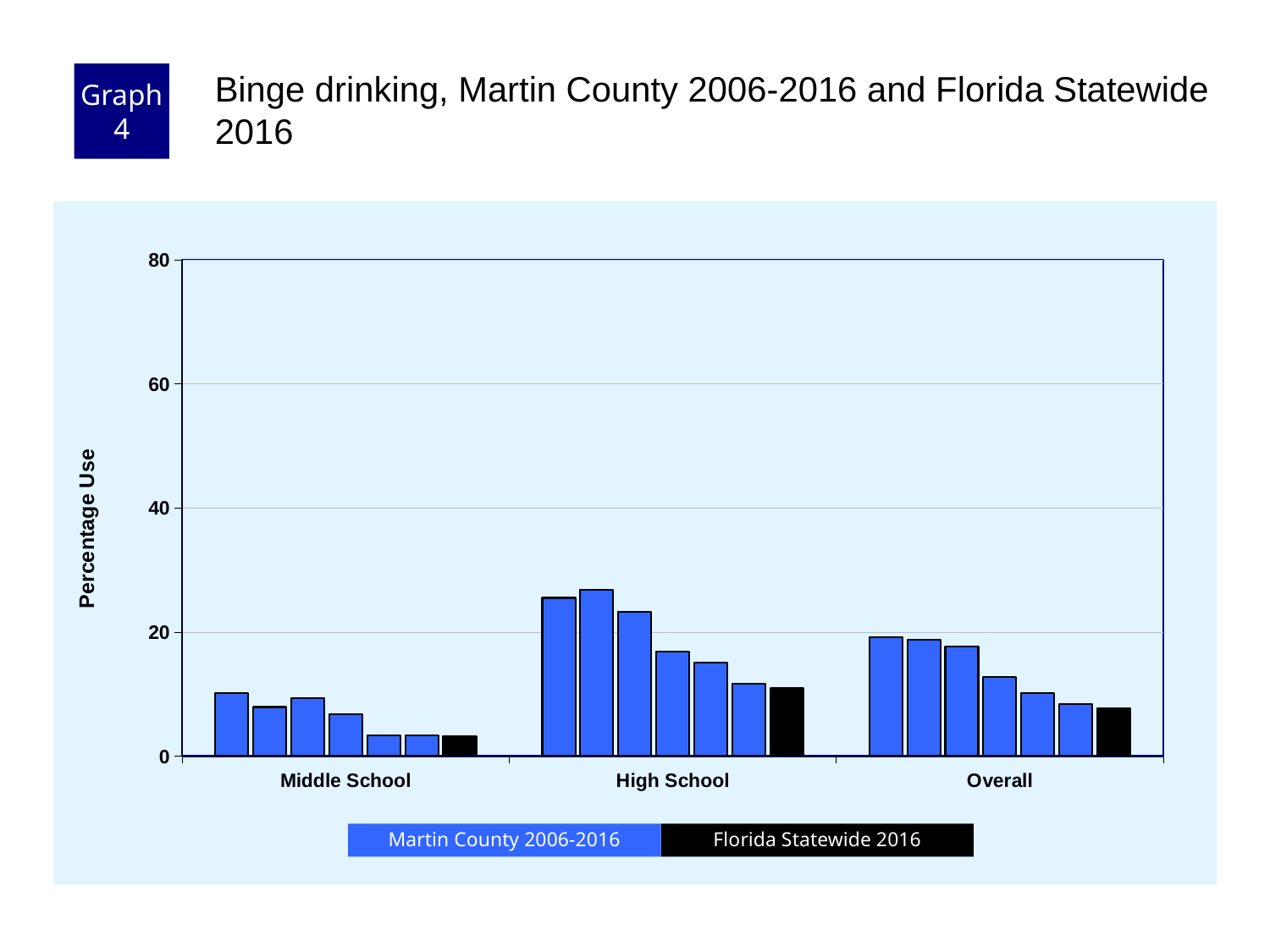
How many school-level categories are shown on the x axis? 3 Is the Florida Statewide 2016 value for High School greater or less than 20? less What is the label on the y axis? Percentage Use Is the Florida Statewide 2016 value for Overall greater or less than 20? less Is the tallest Martin County bar for High School greater or less than 20? greater Which colour represents Florida Statewide 2016 in the legend? black What kind of chart is shown on the slide? bar chart Is the Florida Statewide 2016 value for High School larger or smaller than the Florida Statewide 2016 value for Middle School? larger Within the High School group, do the Martin County bars generally rise or fall from left to right? fall Which category has the shortest bars overall? Middle School Which category has the tallest bars overall? High School How many series does the legend list? 2